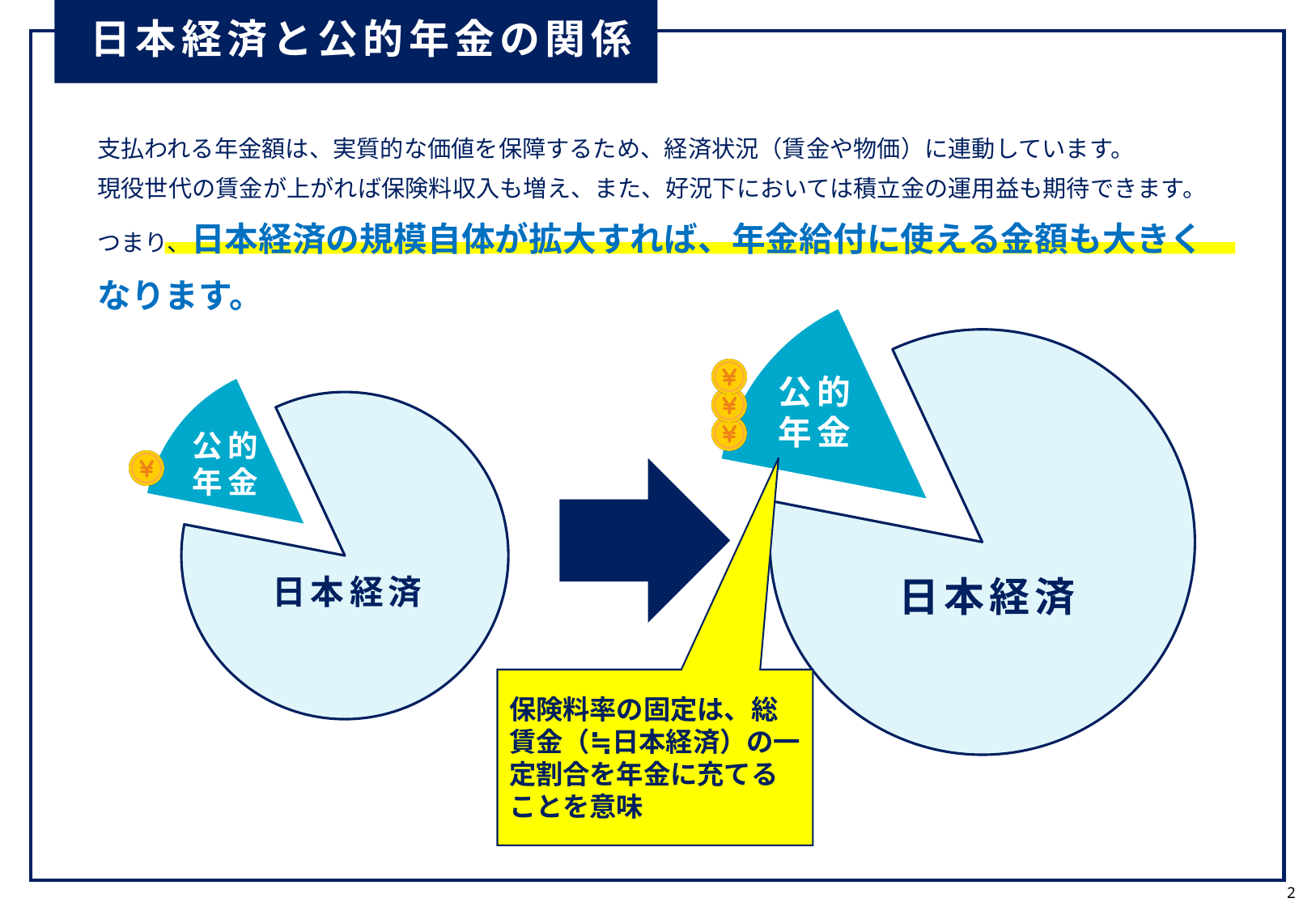
How many slices does the left pie chart have? 2 In the left pie chart, what is the label of the exploded (separated) slice? 公的年金 What kind of chart is shown on the right side of the slide? pie chart How many pie charts are shown on the slide? 2 In the right pie chart, which slice is larger, 公的年金 or 日本経済? 日本経済 What kind of chart is shown on the left side of the slide? pie chart In the right pie chart, which slice is the largest? 日本経済 How many slices does the right pie chart have? 2 In the left pie chart, which slice is larger, 公的年金 or 日本経済? 日本経済 What is the label of the large light-blue slice in the right pie chart? 日本経済 In the left pie chart, which slice is the smallest? 公的年金